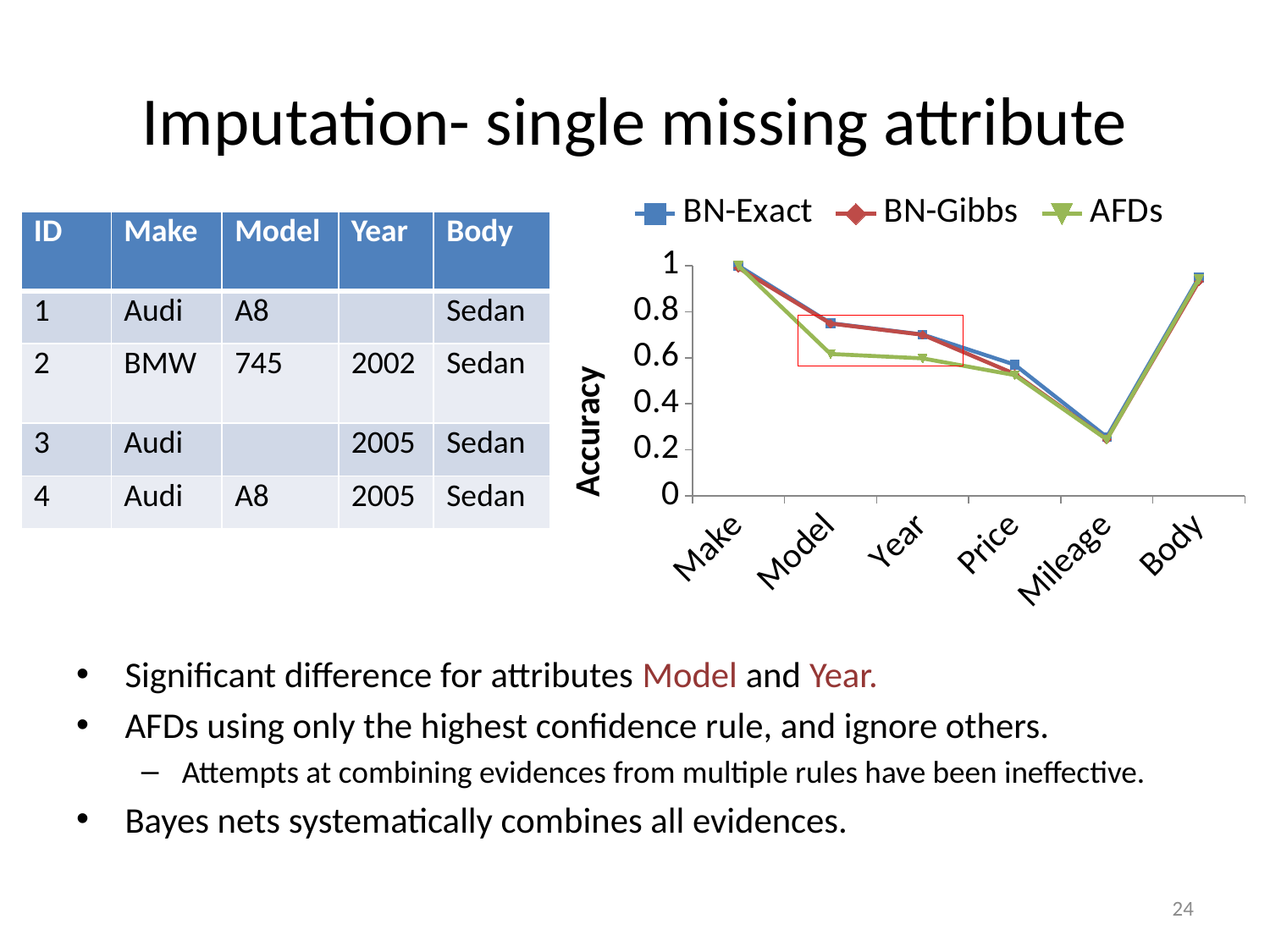
Is the BN-Exact value for Model greater or less than 0.6? greater What is the label on the chart's vertical axis? Accuracy What kind of chart is shown on the slide? line chart Is the AFDs value for Model greater or less than 0.8? less How many series does the chart's legend list? 3 Do the values rise or fall along the x axis from Make to Mileage? fall Is the BN-Gibbs value for Mileage greater or less than 0.4? less At the Model category, which series has the larger value: BN-Exact or AFDs? BN-Exact Which category has the lowest accuracy for all three series? Mileage Which series is shown with a green line in the chart? AFDs How many categories are shown along the x axis of the chart? 6